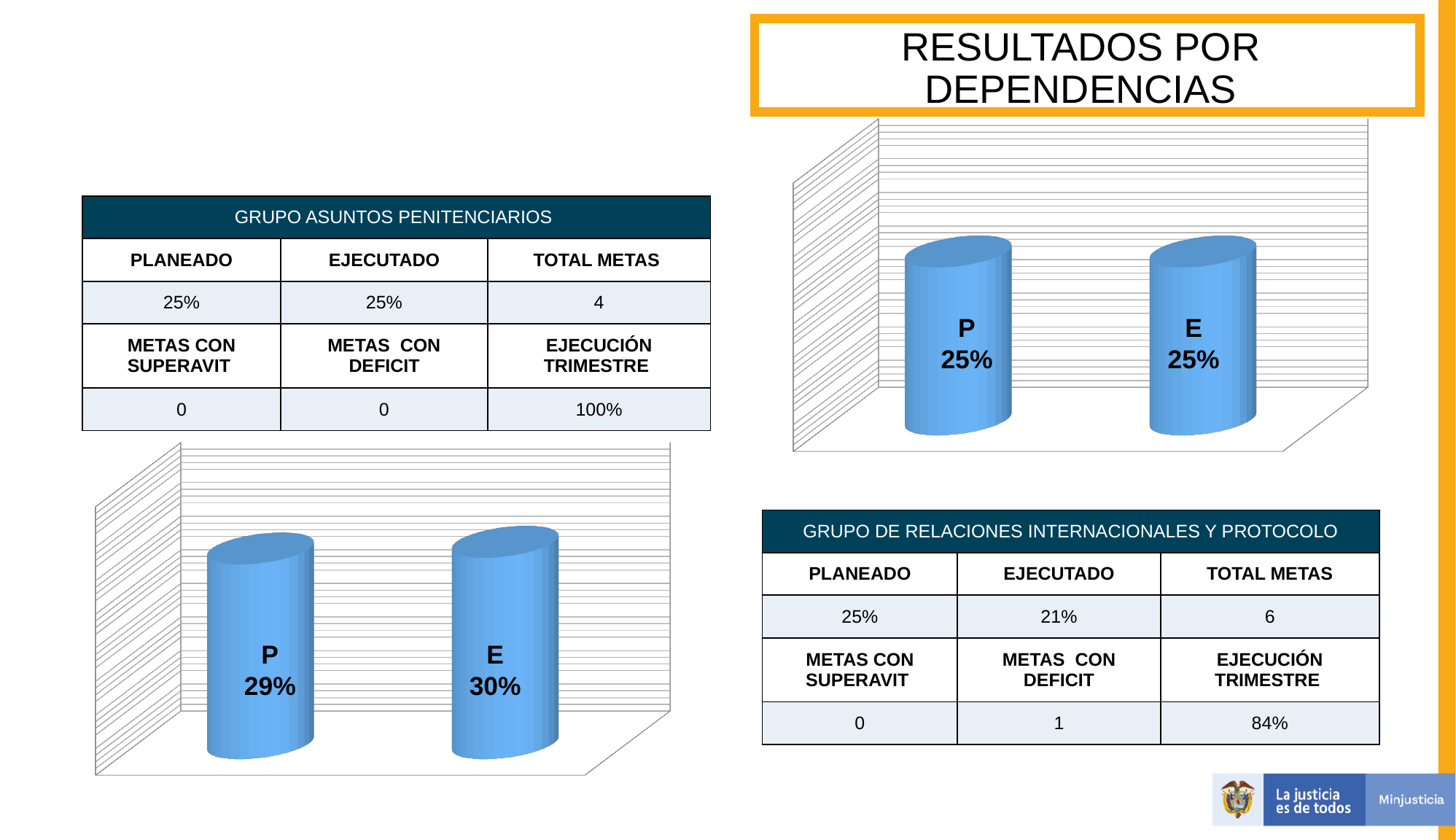
In the chart at the bottom left of the slide, what is the difference between the E value and the P value? 1% What kind of chart is shown at the top right of the slide? Bar chart In the chart at the bottom left of the slide, what is the value labelled on the P bar? 29% In the chart at the top right of the slide, what is the difference between the P value and the E value? 0% How many bars are shown in the chart at the bottom left of the slide? 2 In the chart at the bottom left of the slide, what is the value labelled on the E bar? 30% What are the labels of the two bars in the chart at the bottom left of the slide? P and E How many bars are shown in the chart at the top right of the slide? 2 What colour are the bars in the chart at the top right of the slide? Blue In the chart at the top right of the slide, what is the value labelled on the E bar? 25% In the chart at the top right of the slide, what is the value labelled on the P bar? 25% What kind of chart is shown at the bottom left of the slide? Bar chart